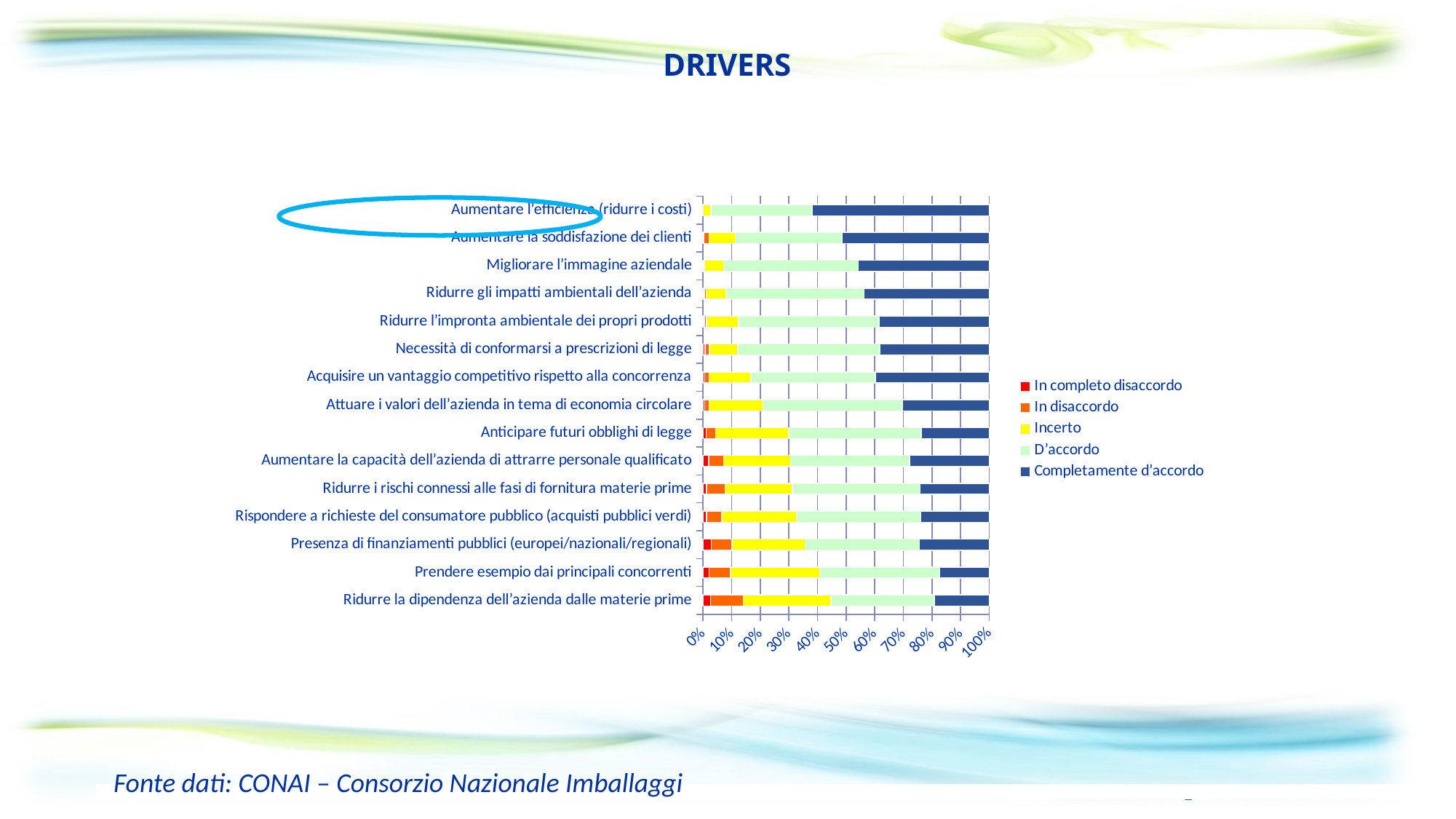
How many series does the chart legend list? 5 Is the 'Completamente d'accordo' value for 'Aumentare l'efficienza (ridurre i costi)' greater or less than 50%? greater Moving down the list of categories from top to bottom, does the 'Completamente d'accordo' share generally rise or fall? fall What is the title of the slide containing the chart? DRIVERS Which category has the largest 'In disaccordo' segment? Ridurre la dipendenza dell'azienda dalle materie prime Is the 'Incerto' value for 'Aumentare l'efficienza (ridurre i costi)' greater or less than 10%? less What kind of chart is shown on the slide? Stacked bar chart Which category label is circled on the chart? Aumentare l'efficienza (ridurre i costi) Which has the larger 'Completamente d'accordo' segment: 'Aumentare l'efficienza (ridurre i costi)' or 'Ridurre la dipendenza dell'azienda dalle materie prime'? Aumentare l'efficienza (ridurre i costi) Is the 'Completamente d'accordo' value for 'Prendere esempio dai principali concorrenti' greater or less than 30%? less How many categories (drivers) are plotted on the chart? 15 Which category has the largest 'Completamente d'accordo' segment? Aumentare l'efficienza (ridurre i costi)